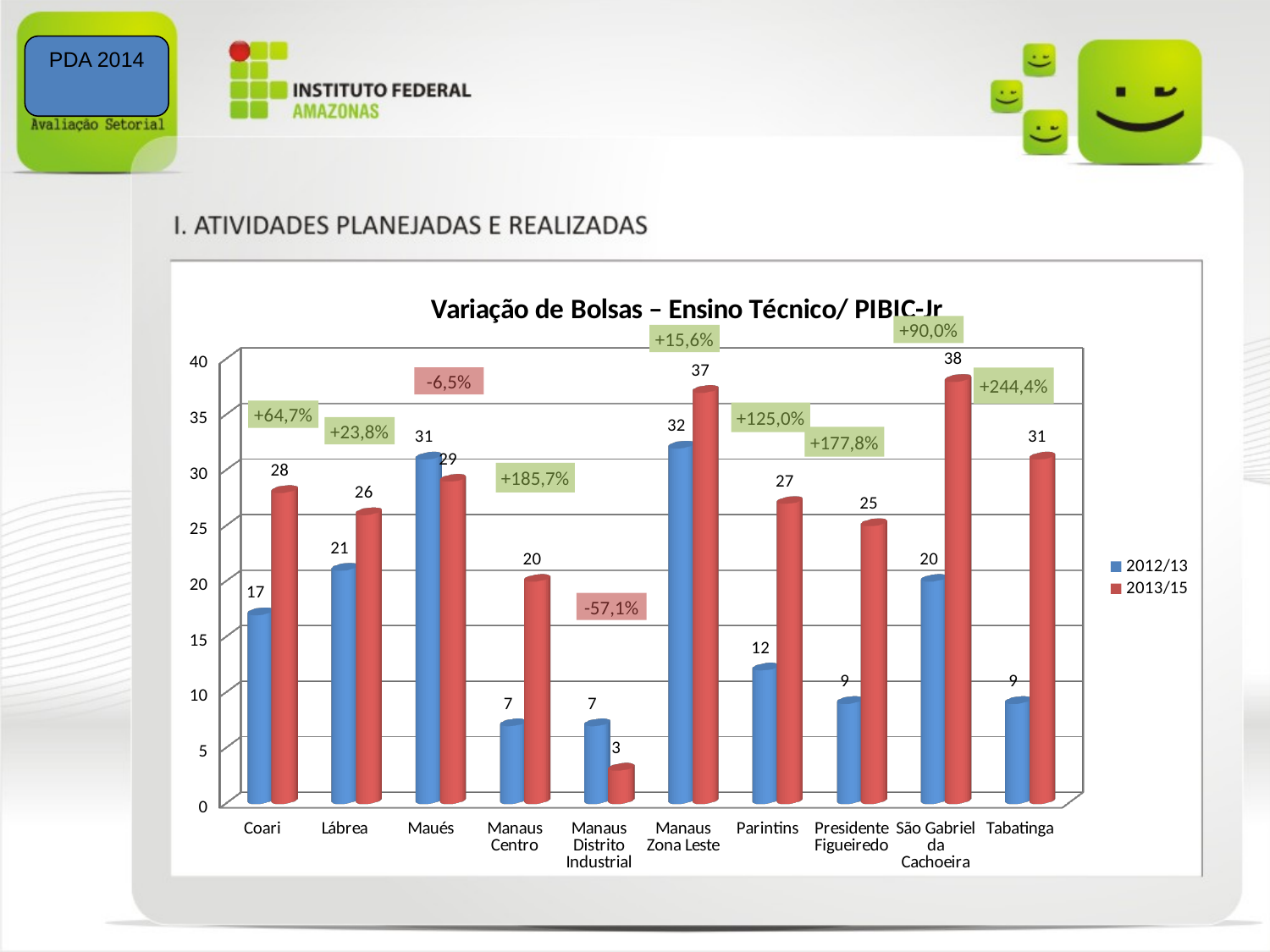
How many categories are shown on the x axis? 10 What is the 2013/15 value for Parintins? 27 What kind of chart is shown on the slide? Bar chart What is the difference between the 2013/15 and 2012/13 values for Tabatinga? 22 How many series does the legend list? 2 What is the title of the chart? Variação de Bolsas – Ensino Técnico/ PIBIC-Jr What percentage change label is shown above São Gabriel da Cachoeira? +90,0% Which category has the highest 2013/15 value? São Gabriel da Cachoeira What is the 2012/13 value for Manaus Zona Leste? 32 Which category has the lowest 2013/15 value? Manaus Distrito Industrial For Maués, which series has the larger value, 2012/13 or 2013/15? 2012/13 Which category has the highest 2012/13 value? Manaus Zona Leste